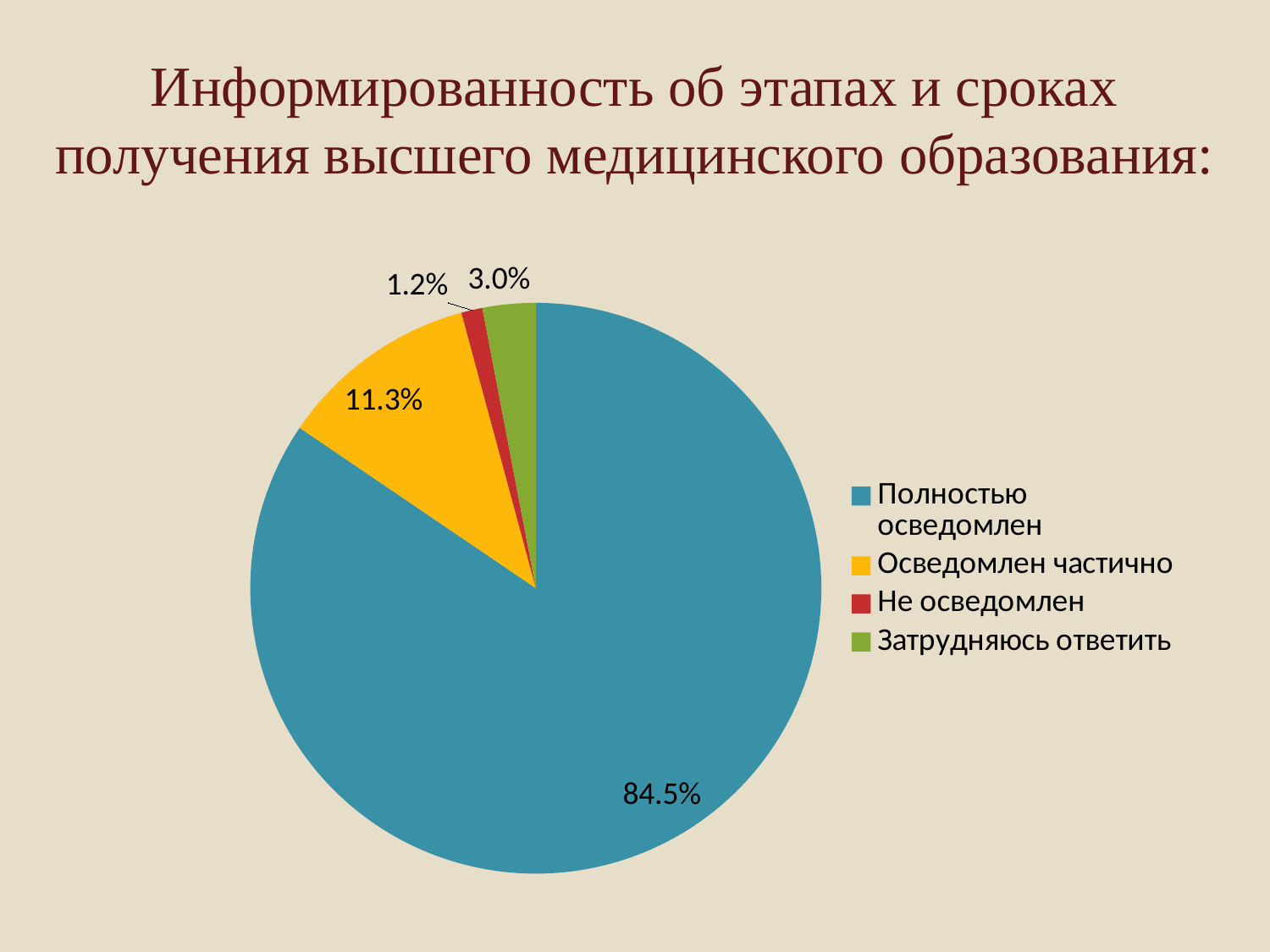
How many entries does the legend list? 4 How many categories does the pie chart show? 4 What share of the pie is labelled "Осведомлен частично"? 11.3% What type of chart is shown on the slide? pie chart Which is larger: the share for "Затрудняюсь ответить" or the share for "Не осведомлен"? Затрудняюсь ответить What is the difference between the shares for "Полностью осведомлен" and "Осведомлен частично"? 73.2% What share of the pie is labelled "Полностью осведомлен"? 84.5% What colour is the slice for "Осведомлен частично"? yellow Which category has the smallest slice of the pie? Не осведомлен What share of the pie is labelled "Не осведомлен"? 1.2% Which category has the largest slice of the pie? Полностью осведомлен What share of the pie is labelled "Затрудняюсь ответить"? 3.0%